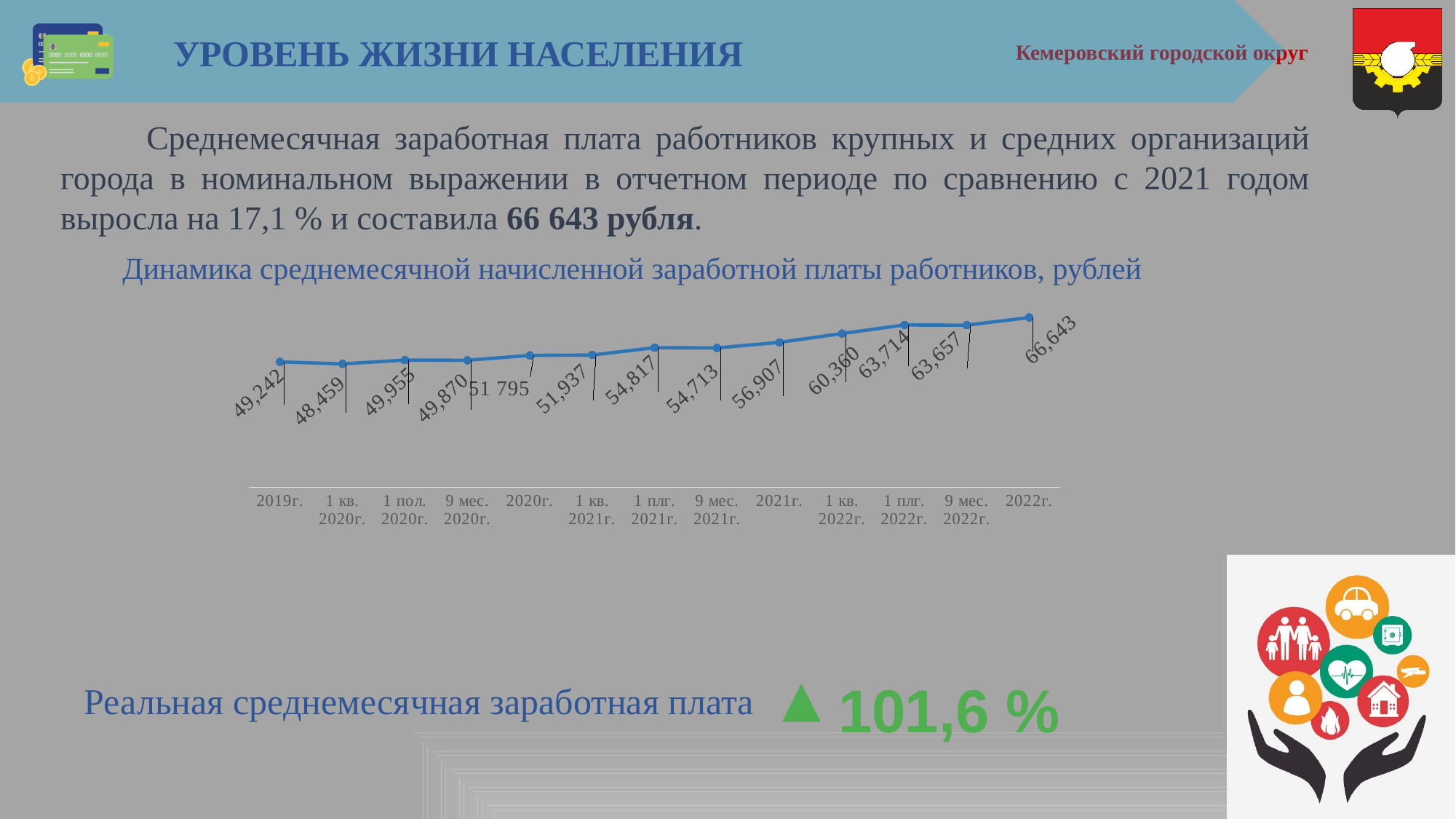
What is the difference between the values for 2022г. and 2021г.? 9,736 What is the value for 9 мес. 2021г. in the chart? 54,713 What is the value for 2019г. in the chart? 49,242 What is the value for 2021г. in the chart? 56,907 What is the value for 1 кв. 2022г. in the chart? 60,360 Which period has the highest value in the chart? 2022г. What type of chart is shown on the slide? line chart Which period has the lowest value in the chart? 1 кв. 2020г. Which is larger, the value for 2020г. or the value for 2021г.? 2021г. What is the value for 2022г. in the chart? 66,643 How many data points are plotted in the chart? 13 Do the values generally rise or fall from 2019г. to 2022г.? rise